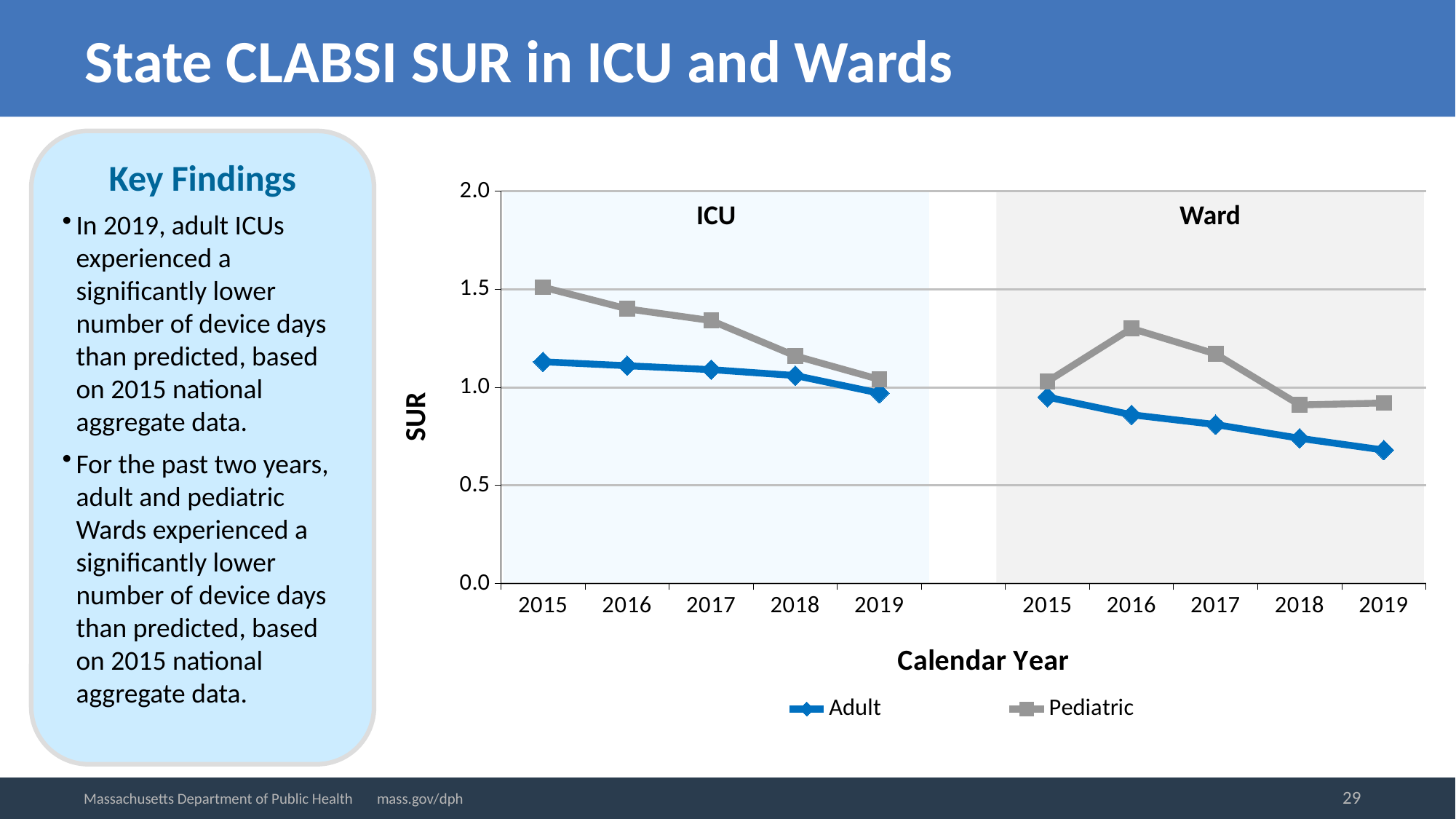
What kind of chart is shown on the slide? line chart In the ICU section, which year has the highest Pediatric SUR? 2015 In the Ward section, which year has the highest Pediatric SUR? 2016 How many years are plotted in the ICU section of the chart? 5 What is the title of the chart's x axis? Calendar Year In the Ward section, which year has the lowest Adult SUR? 2019 How many series does the chart legend list? 2 What are the two series named in the chart legend? Adult and Pediatric Is the Adult SUR in the Ward section for 2019 greater or less than 1.0? less Does the Adult SUR in the Ward section rise or fall from 2015 to 2019? fall Does the Adult SUR in the ICU section rise or fall from 2015 to 2019? fall In the ICU section for 2015, which series has the higher SUR, Adult or Pediatric? Pediatric